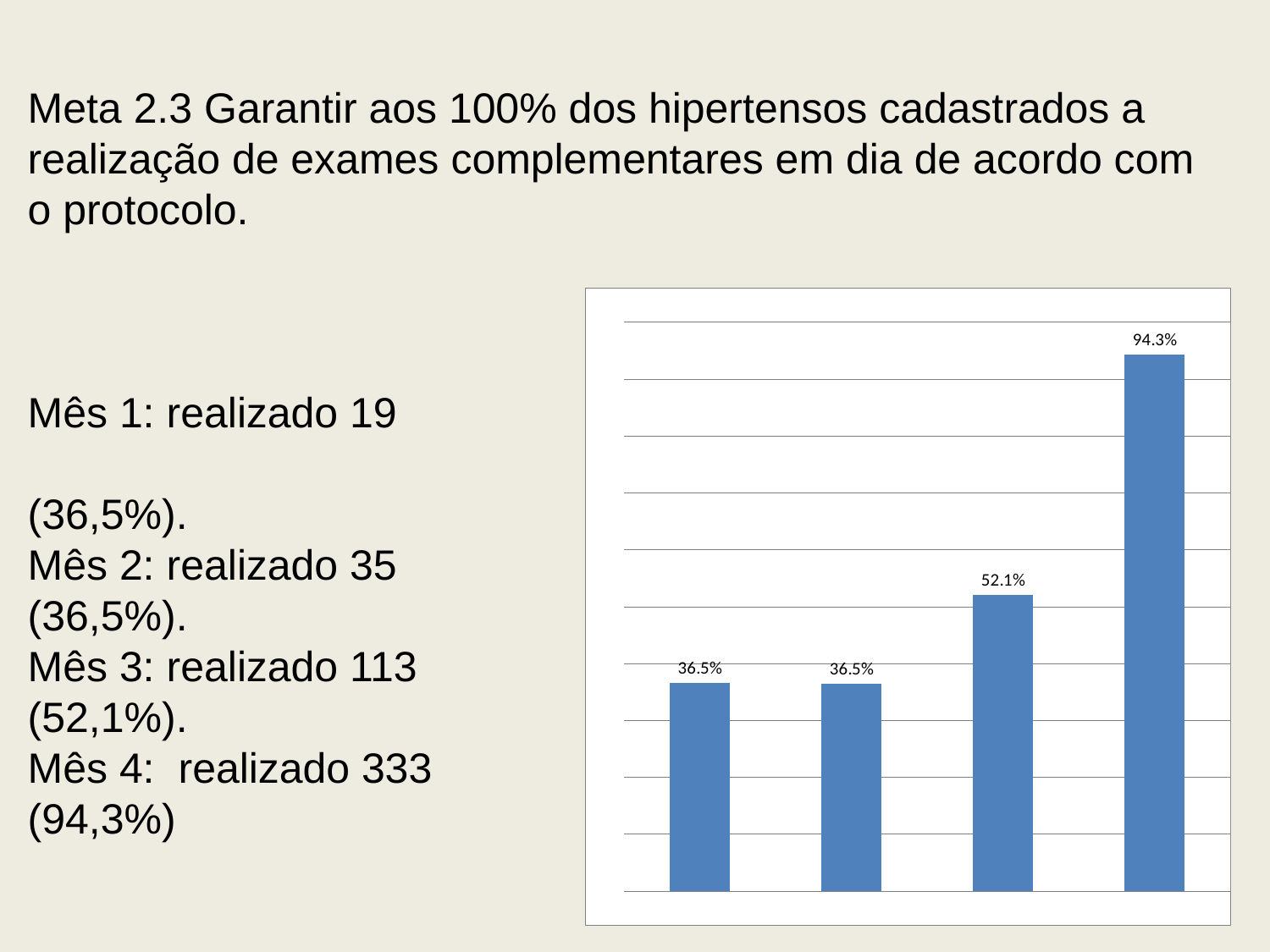
Which bar has the highest value in the chart? The fourth bar (94.3%) Do the bar values rise or fall from left to right across the chart? Rise Which bars share the lowest value in the chart? The first and second bars (36.5%) What colour are the bars in the chart? Blue What kind of chart is shown on the slide? Bar chart How many bars does the chart contain? 4 What is the difference between the third bar (52.1%) and the second bar (36.5%)? 15.6 percentage points What value is labelled on the third bar of the chart? 52.1% What value is labelled on the tallest (fourth) bar of the chart? 94.3% What value is labelled on the first bar of the chart? 36.5% Which is larger, the value of the third bar or the value of the fourth bar? The fourth bar What is the difference between the fourth bar (94.3%) and the third bar (52.1%)? 42.2 percentage points